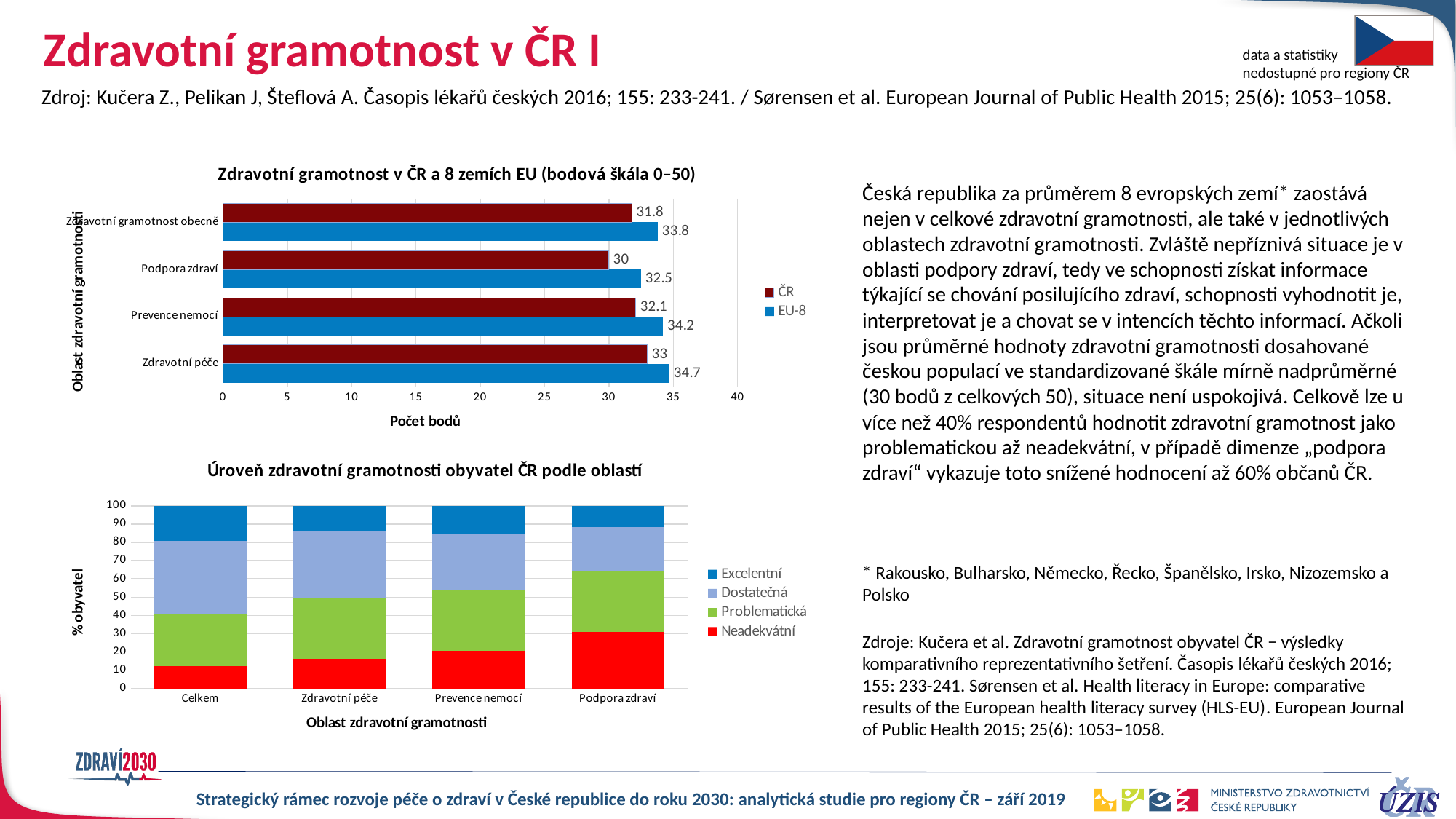
In the chart 'Zdravotní gramotnost v ČR a 8 zemích EU', what is the EU-8 value for Prevence nemocí? 34.2 In the chart 'Zdravotní gramotnost v ČR a 8 zemích EU', is the ČR value for Zdravotní péče larger or smaller than the EU-8 value? smaller In the chart 'Úroveň zdravotní gramotnosti obyvatel ČR podle oblastí', is the Neadekvátní value for Podpora zdraví greater or less than 20? greater In the chart 'Zdravotní gramotnost v ČR a 8 zemích EU', what is the EU-8 value for Zdravotní péče? 34.7 In the chart 'Zdravotní gramotnost v ČR a 8 zemích EU', what is the difference between the EU-8 and ČR values for Podpora zdraví? 2.5 In the chart 'Úroveň zdravotní gramotnosti obyvatel ČR podle oblastí', which colour represents the Problematická series? green How many series does the legend of the chart 'Zdravotní gramotnost v ČR a 8 zemích EU' list? 2 What type of chart is 'Úroveň zdravotní gramotnosti obyvatel ČR podle oblastí'? stacked bar chart In the chart 'Zdravotní gramotnost v ČR a 8 zemích EU', which category has the highest EU-8 value? Zdravotní péče In the chart 'Zdravotní gramotnost v ČR a 8 zemích EU', what is the ČR value for Podpora zdraví? 30 How many categories are shown on the x axis of the chart 'Úroveň zdravotní gramotnosti obyvatel ČR podle oblastí'? 4 In the chart 'Zdravotní gramotnost v ČR a 8 zemích EU', which category has the lowest ČR value? Podpora zdraví